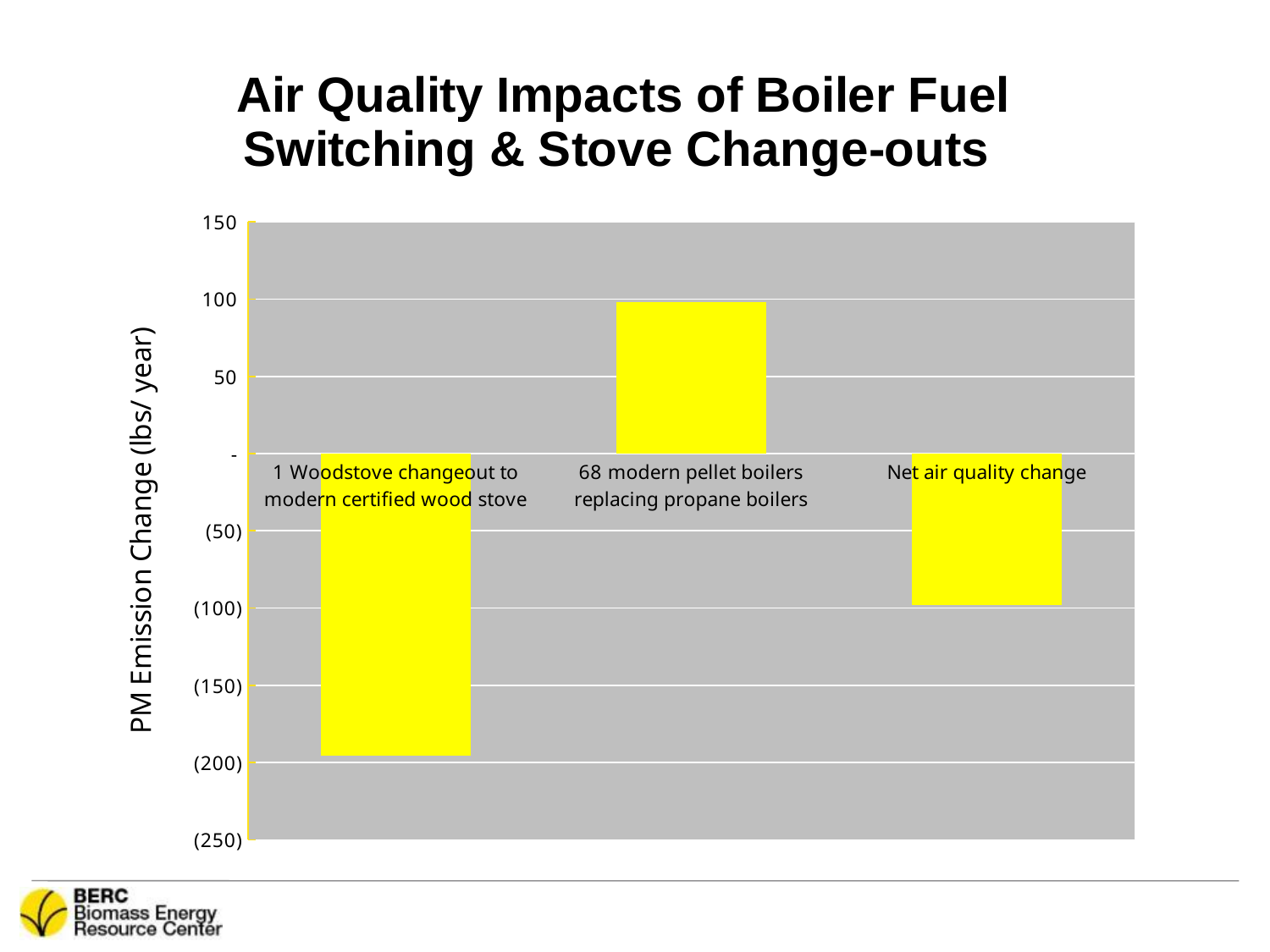
How many categories are plotted in the chart? 3 Which is larger, the value for '68 modern pellet boilers replacing propane boilers' or the value for 'Net air quality change'? 68 modern pellet boilers replacing propane boilers What kind of chart is shown on the slide? bar chart Is the value for '68 modern pellet boilers replacing propane boilers' greater or less than 50? greater What is the title of the y axis of the chart? PM Emission Change (lbs/ year) Is the value for '1 Woodstove changeout to modern certified wood stove' greater or less than 0? less Is the value for 'Net air quality change' greater or less than (50)? less Which is larger, the value for 'Net air quality change' or the value for '1 Woodstove changeout to modern certified wood stove'? Net air quality change What colour are the bars in the chart? yellow Which category has the highest PM emission change? 68 modern pellet boilers replacing propane boilers Which category has the lowest PM emission change? 1 Woodstove changeout to modern certified wood stove